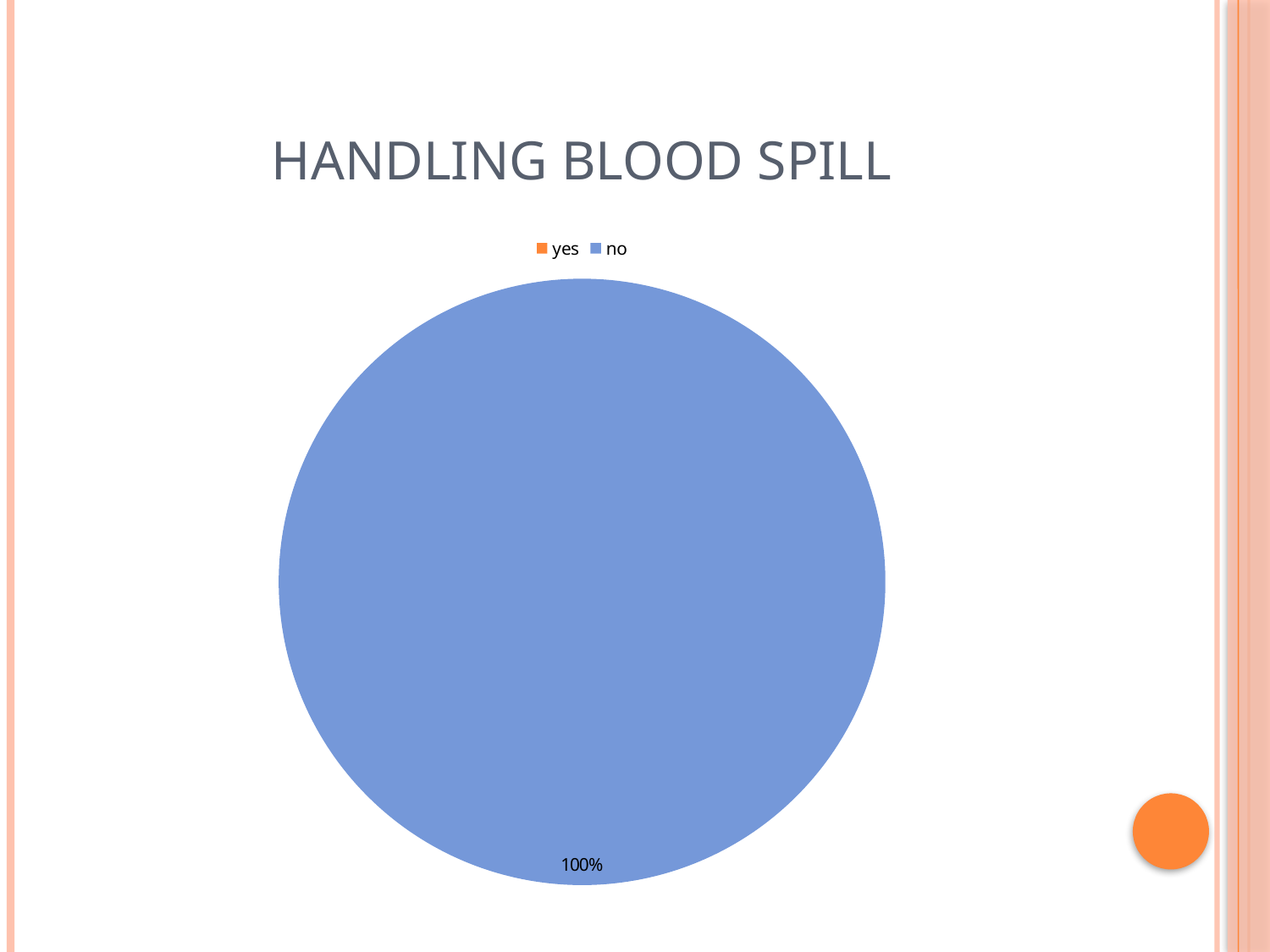
Which category takes the largest share of the pie? no What kind of chart is shown on the slide? pie chart What colour is the "no" slice of the pie? blue What share of the pie does the "no" slice take? 100% Which is larger, the share for "yes" or the share for "no"? no What is the title of the chart? HANDLING BLOOD SPILL Which category takes the smallest share of the pie? yes How many entries does the legend list? 2 What is the data label printed on the pie? 100%